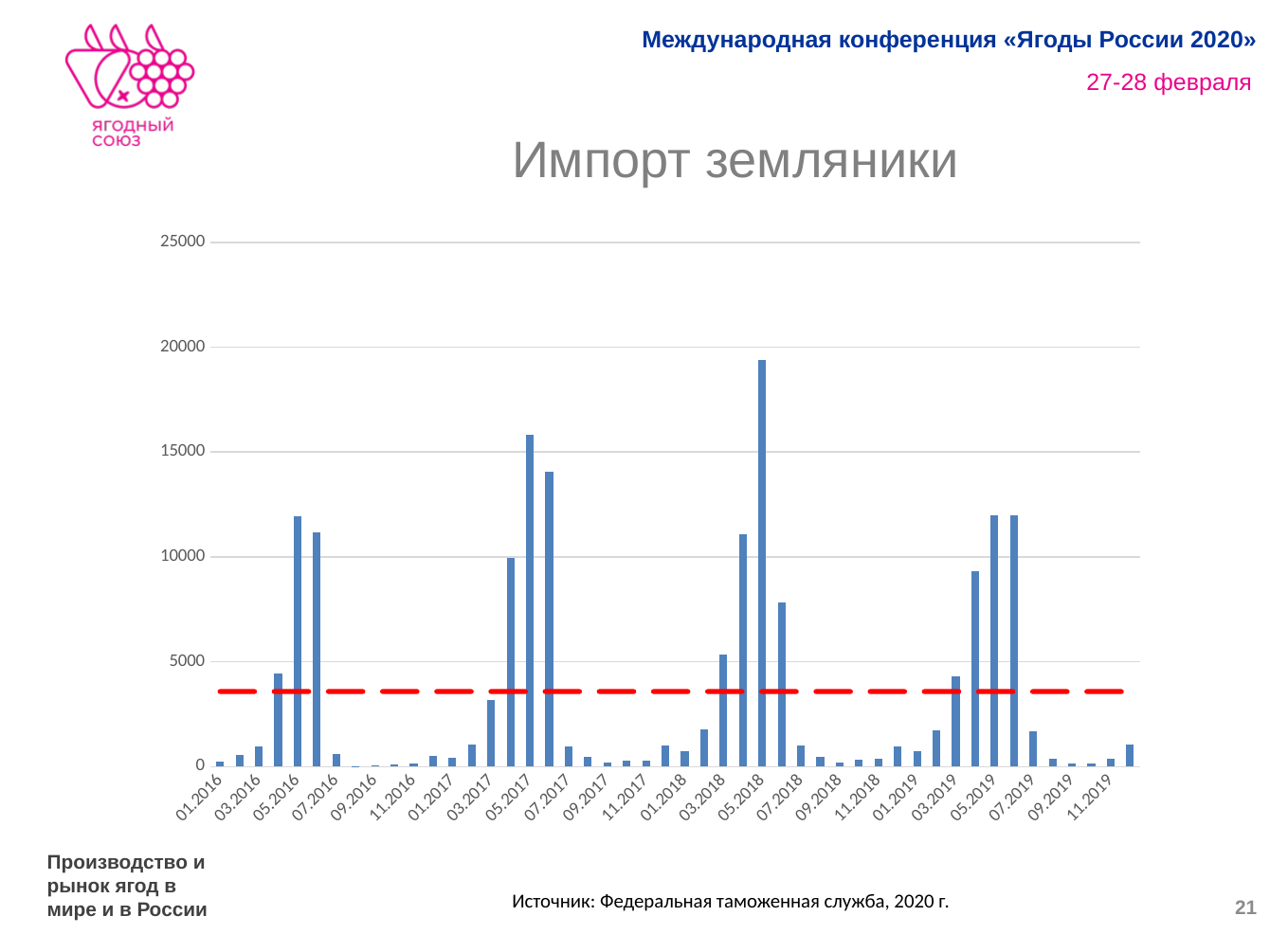
Is the value for 05.2018 greater or less than 15000? greater Which month has the highest bar in the chart? 05.2018 Is the value for 03.2017 greater or less than 5000? less Which is larger, the value for 05.2019 or the value for 07.2019? 05.2019 What is the highest value shown on the vertical axis? 25000 What kind of chart is shown on the slide? bar chart Is the value for 01.2016 greater or less than 5000? less Which is larger, the value for 05.2018 or the value for 05.2016? 05.2018 What is the title of the chart? Импорт земляники